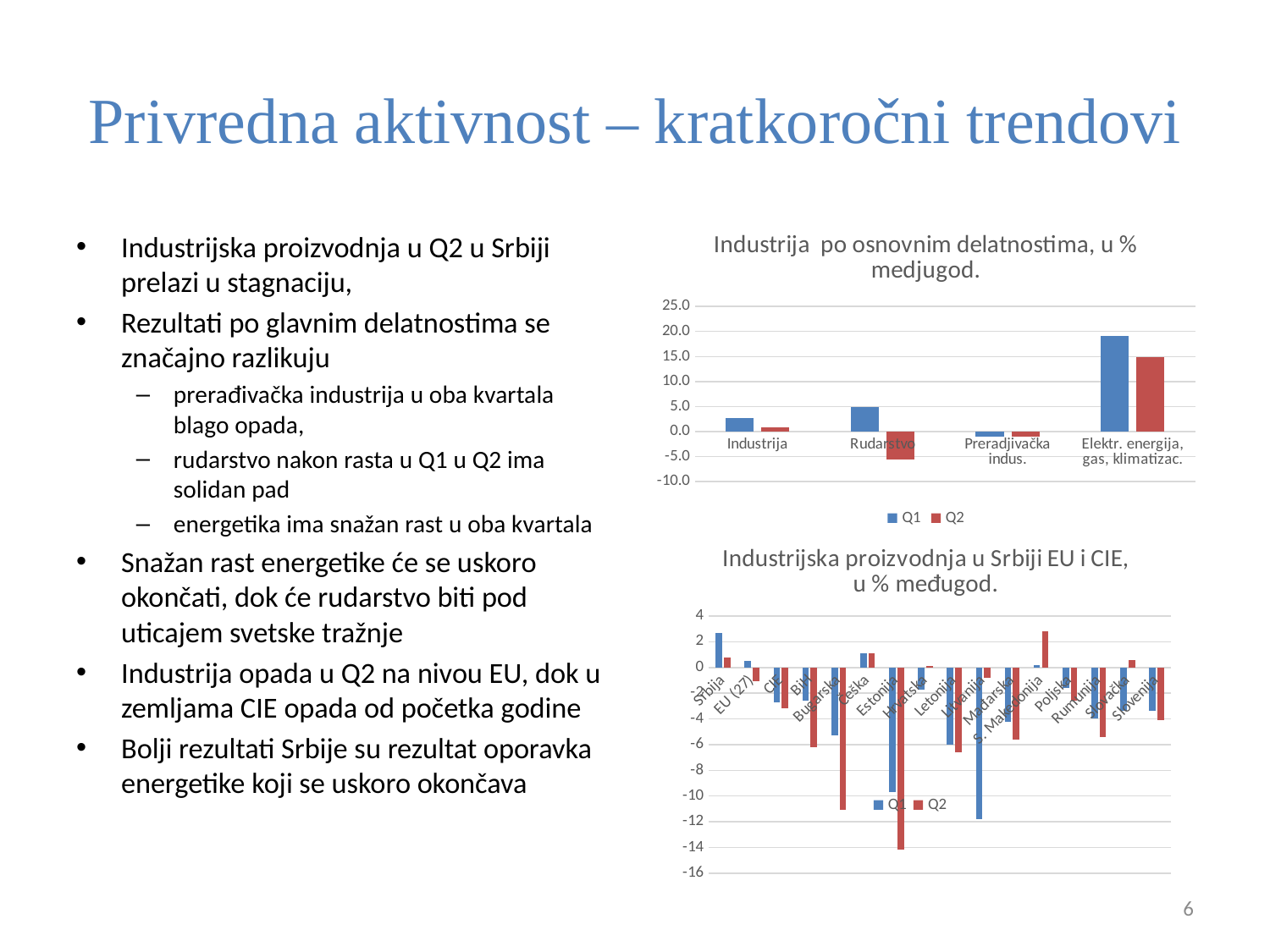
In the top chart (Industrija po osnovnim delatnostima), which category has the lowest Q2 value? Rudarstvo In the bottom chart (Industrijska proizvodnja u Srbiji EU i CIE), is the Q1 value for Srbija greater or less than 2? greater What is the title of the bottom chart on the slide? Industrijska proizvodnja u Srbiji EU i CIE, u % međugod. In the top chart (Industrija po osnovnim delatnostima), how many categories are shown on the x axis? 4 In the top chart (Industrija po osnovnim delatnostima), how many series does the legend list? 2 In the bottom chart (Industrijska proizvodnja u Srbiji EU i CIE), how many countries/regions are shown on the x axis? 16 In the top chart (Industrija po osnovnim delatnostima), is the Q1 value for Elektr. energija, gas, klimatizac. greater or less than 15.0? greater In the bottom chart (Industrijska proizvodnja u Srbiji EU i CIE), which category has the lowest Q2 value? Estonija What type of chart is the top chart titled "Industrija po osnovnim delatnostima, u % medjugod."? bar chart In the top chart (Industrija po osnovnim delatnostima), which is larger for Elektr. energija, gas, klimatizac.: Q1 or Q2? Q1 In the top chart (Industrija po osnovnim delatnostima), which category has the highest Q1 value? Elektr. energija, gas, klimatizac. In the top chart (Industrija po osnovnim delatnostima), is the Q2 value for Rudarstvo greater or less than 0.0? less